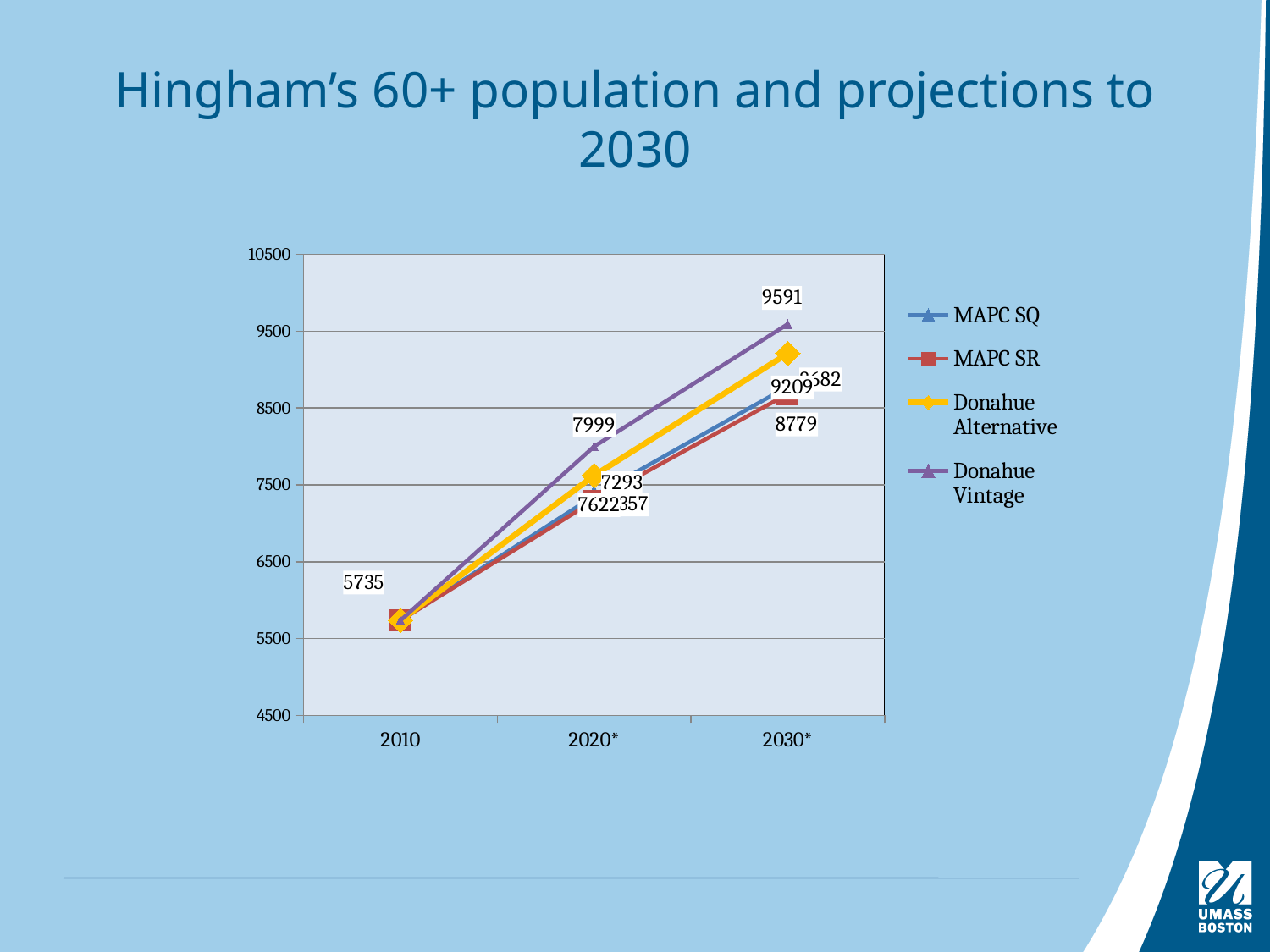
Which series has the highest projected value in 2030*? Donahue Vintage What kind of chart is shown on the slide? line chart By how much does the Donahue Vintage projection increase from 2020* to 2030*? 1592 What is the 60+ population value shown for 2010? 5735 How many years are shown on the x axis? 3 Do the projected values rise or fall from 2010 to 2030*? rise What is the difference between the Donahue Vintage 2030* projection and the 2010 value? 3856 How many series does the legend list? 4 Is the Donahue Alternative value for 2030* greater or less than 8500? greater What is the Donahue Vintage projection for 2030*? 9591 What is the Donahue Vintage projection for 2020*? 7999 Is the MAPC SR value for 2020* greater or less than 7500? less